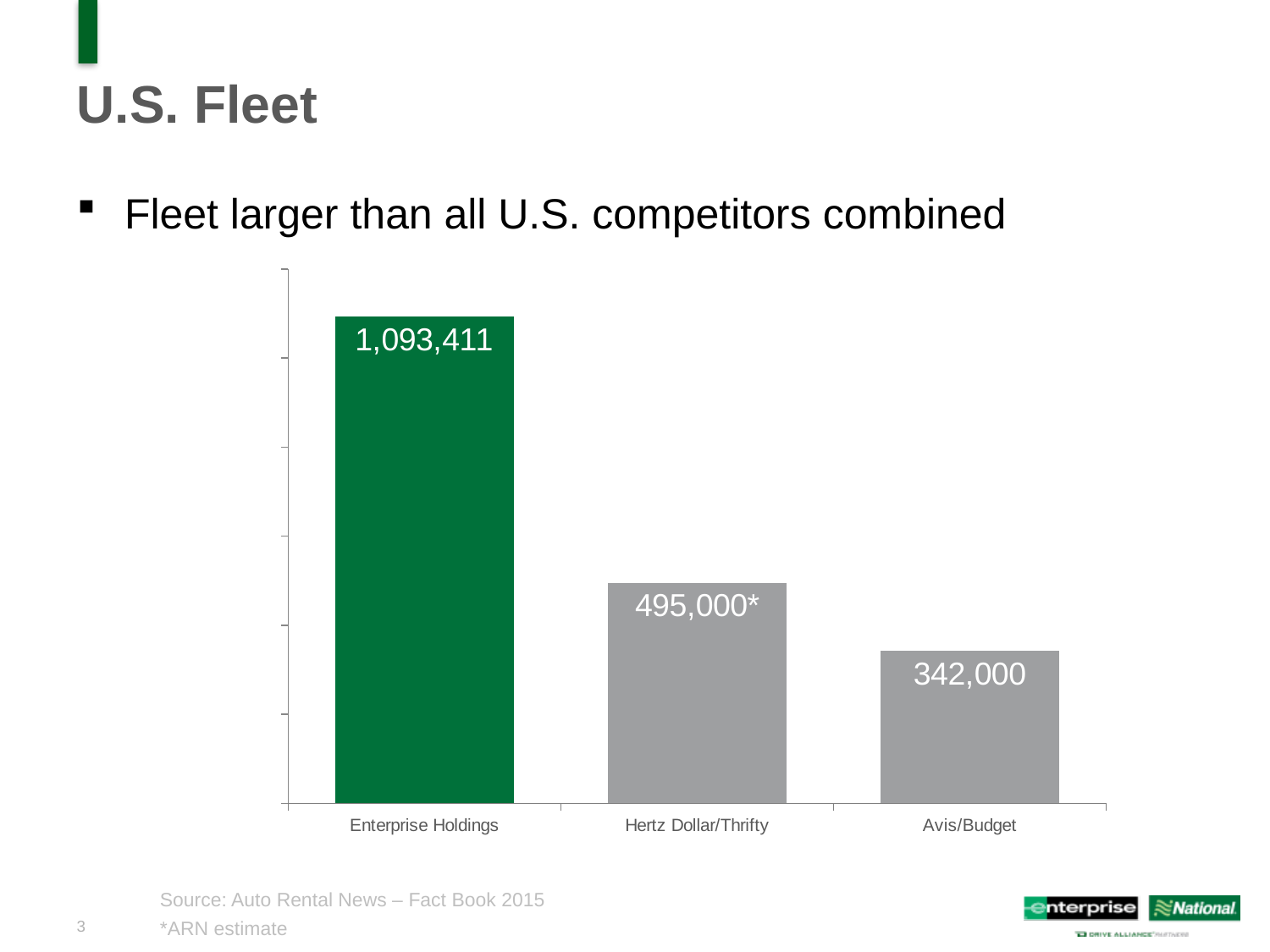
What is the U.S. fleet value shown for Enterprise Holdings? 1,093,411 How many companies are shown in the chart? 3 What is the difference between the Enterprise Holdings fleet and the Hertz Dollar/Thrifty fleet? 598,411 Do the values rise or fall from left to right across the chart? Fall What is the value shown for Hertz Dollar/Thrifty? 495,000* What is the value shown for Avis/Budget? 342,000 Which company has the smallest fleet in the chart? Avis/Budget Which company has the largest fleet in the chart? Enterprise Holdings What is the difference between the Hertz Dollar/Thrifty fleet and the Avis/Budget fleet? 153,000 Which is larger, the fleet of Hertz Dollar/Thrifty or Avis/Budget? Hertz Dollar/Thrifty Which bar in the chart is coloured green? Enterprise Holdings What kind of chart is shown on the slide? Bar chart